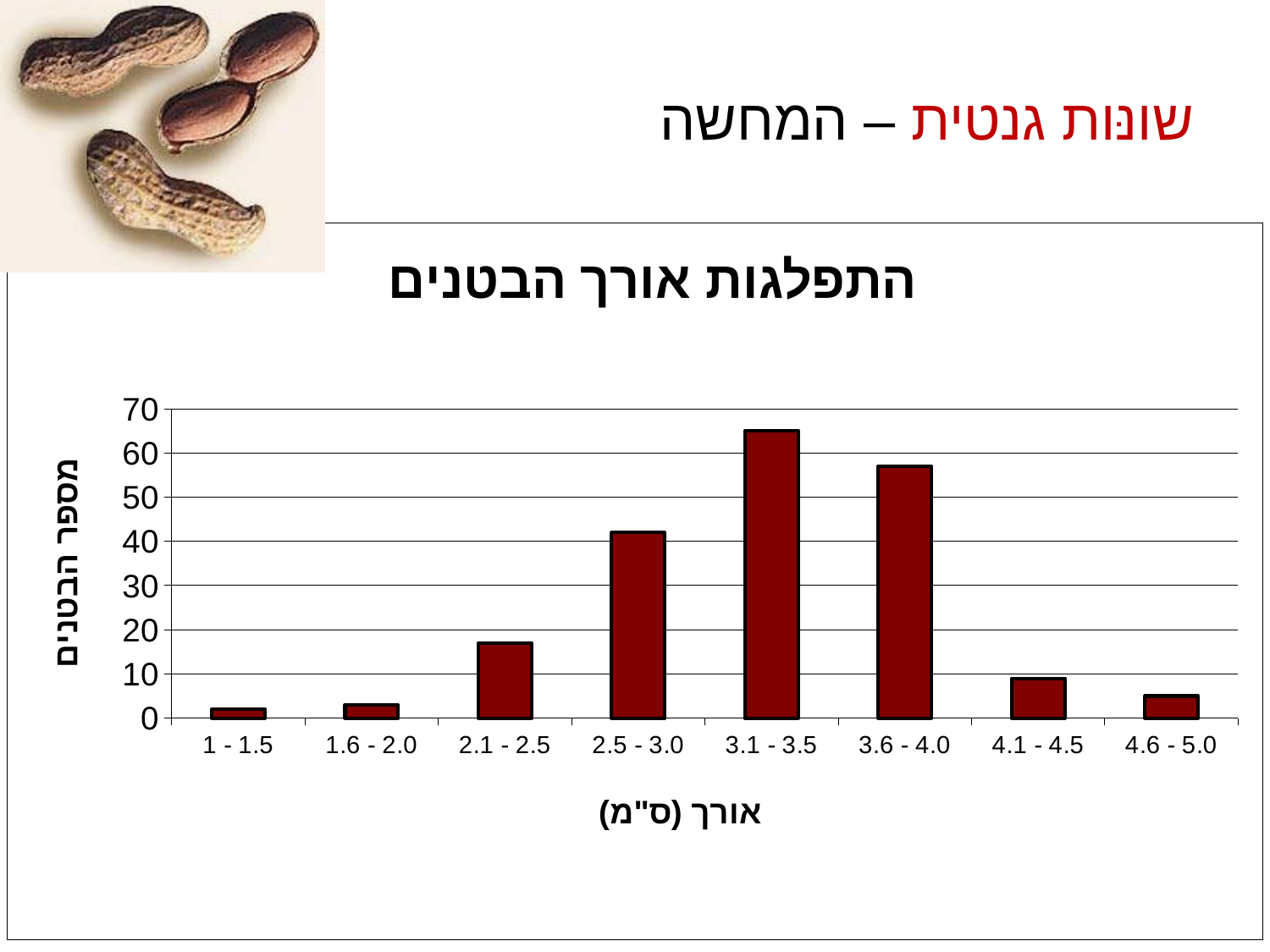
What kind of chart is shown on the slide? bar chart Which has a larger value, the 3.6 - 4.0 category or the 2.5 - 3.0 category? 3.6 - 4.0 Is the value for the 2.1 - 2.5 category greater or less than 20? less Is the value for the 3.1 - 3.5 category greater or less than 60? greater How many length categories are shown on the x axis of the chart? 8 Is the value for the 3.6 - 4.0 category greater or less than 50? greater Which has a larger value, the 2.1 - 2.5 category or the 4.1 - 4.5 category? 2.1 - 2.5 What is the title of the chart? התפלגות אורך הבטנים Which length category has the highest number of peanuts? 3.1 - 3.5 How do the values change along the x axis from 1 - 1.5 to 4.6 - 5.0? They rise to a peak at 3.1 - 3.5 and then fall